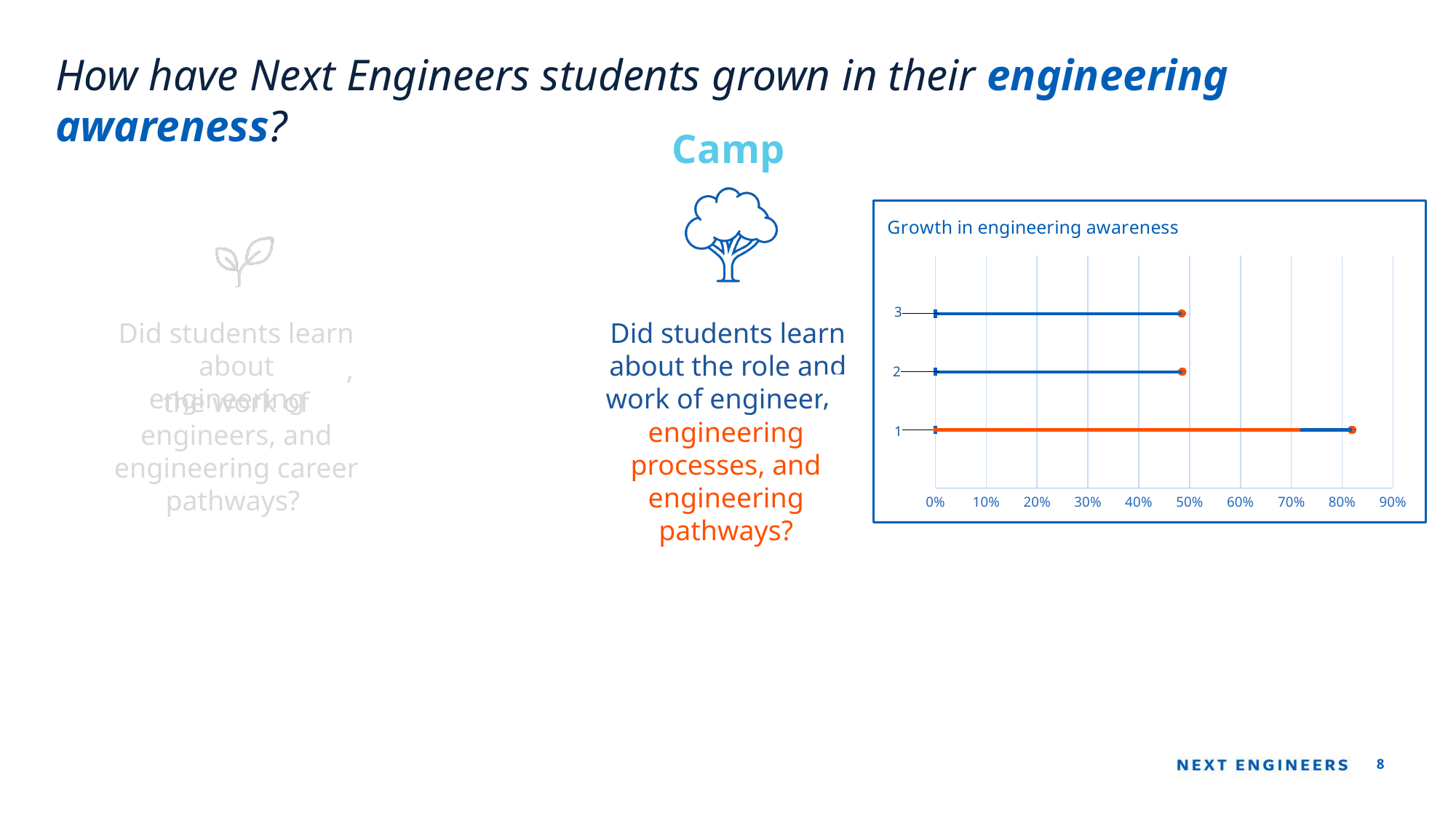
Is the value for category 2 greater or less than 40%? greater Which category has the longest bar in the chart? 1 Is the value for category 3 greater or less than 60%? less Is the value for category 1 greater or less than 60%? greater Which has the larger value, category 1 or category 2? category 1 What is the title of the chart on the slide? Growth in engineering awareness How many categories are plotted on the chart's vertical axis? 3 What is the highest value labelled on the chart's horizontal axis? 90% What type of chart is shown on the slide? bar chart